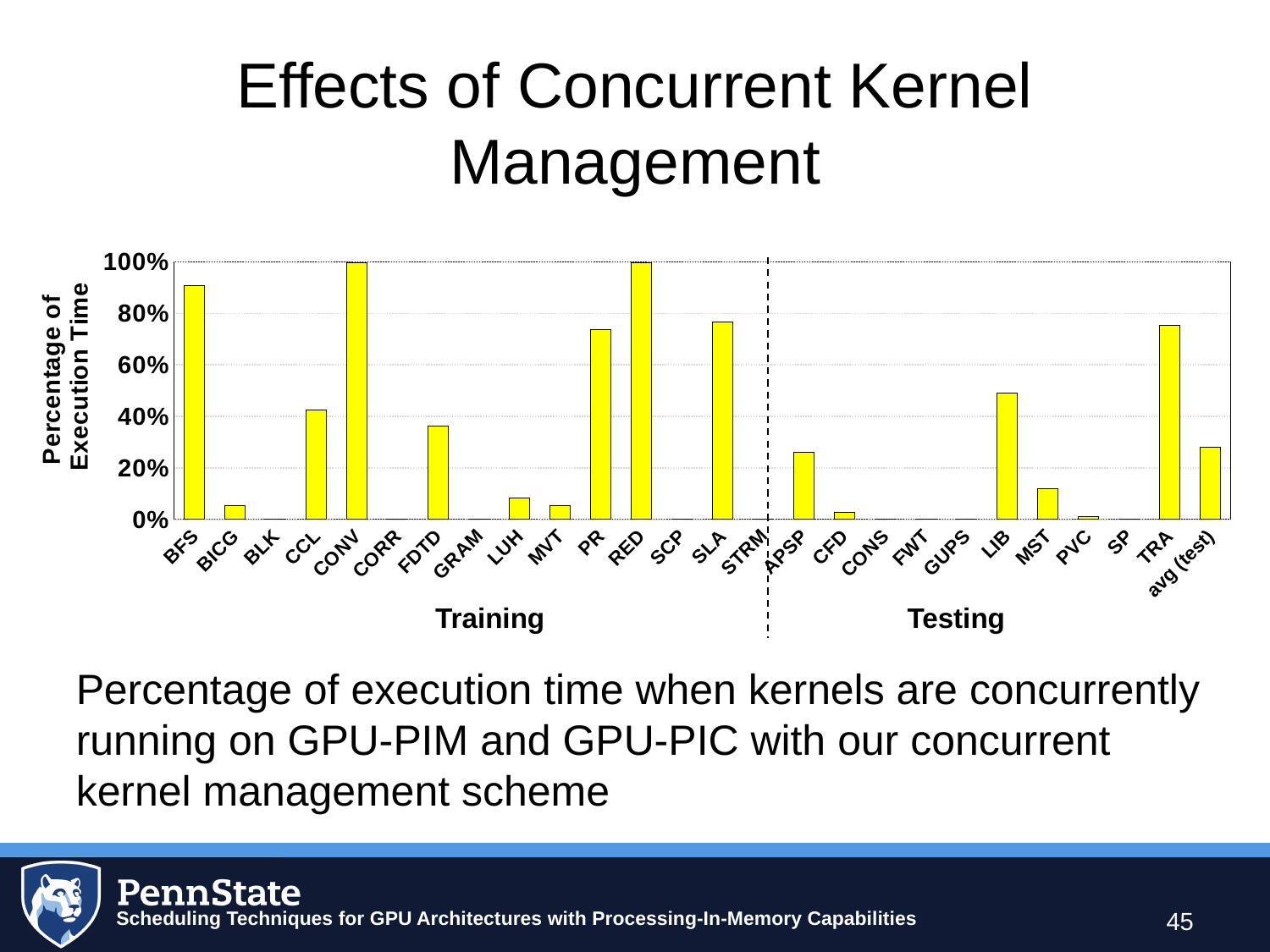
Is the value for APSP greater or less than 40%? less Which is larger, the value for FDTD or the value for PR? PR What kind of chart is shown on the slide? bar chart Which is larger, the value for TRA or the value for MST? TRA What is the label on the y axis of the chart? Percentage of Execution Time Is the value for CCL greater or less than 60%? less How many categories are plotted along the x axis of the chart? 26 Is the value for LIB greater or less than 40%? greater What are the two groups the x axis categories are divided into? Training and Testing